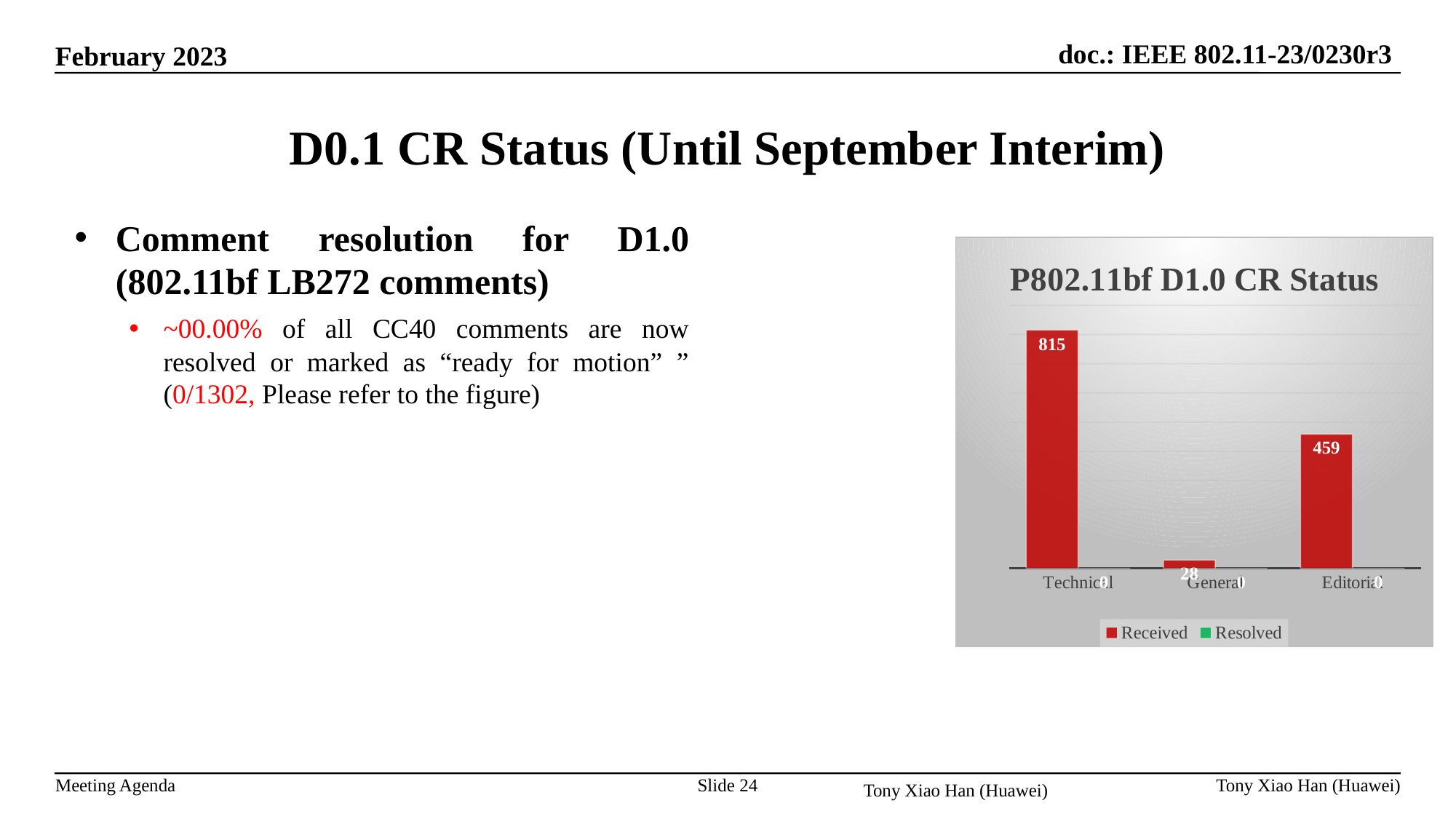
What is the Received value for Technical? 815 How many series does the chart legend list? 2 What is the Received value for General? 28 What is the Received value for Editorial? 459 How many categories are shown on the x axis of the chart? 3 What is the difference between the Received values for Technical and Editorial? 356 Which category has the lowest Received value? General What are the two series named in the chart legend? Received and Resolved What kind of chart is shown on the slide? bar chart Which category has the highest Received value? Technical What is the title of the chart? P802.11bf D1.0 CR Status Which is larger, the Received value for Editorial or for General? Editorial